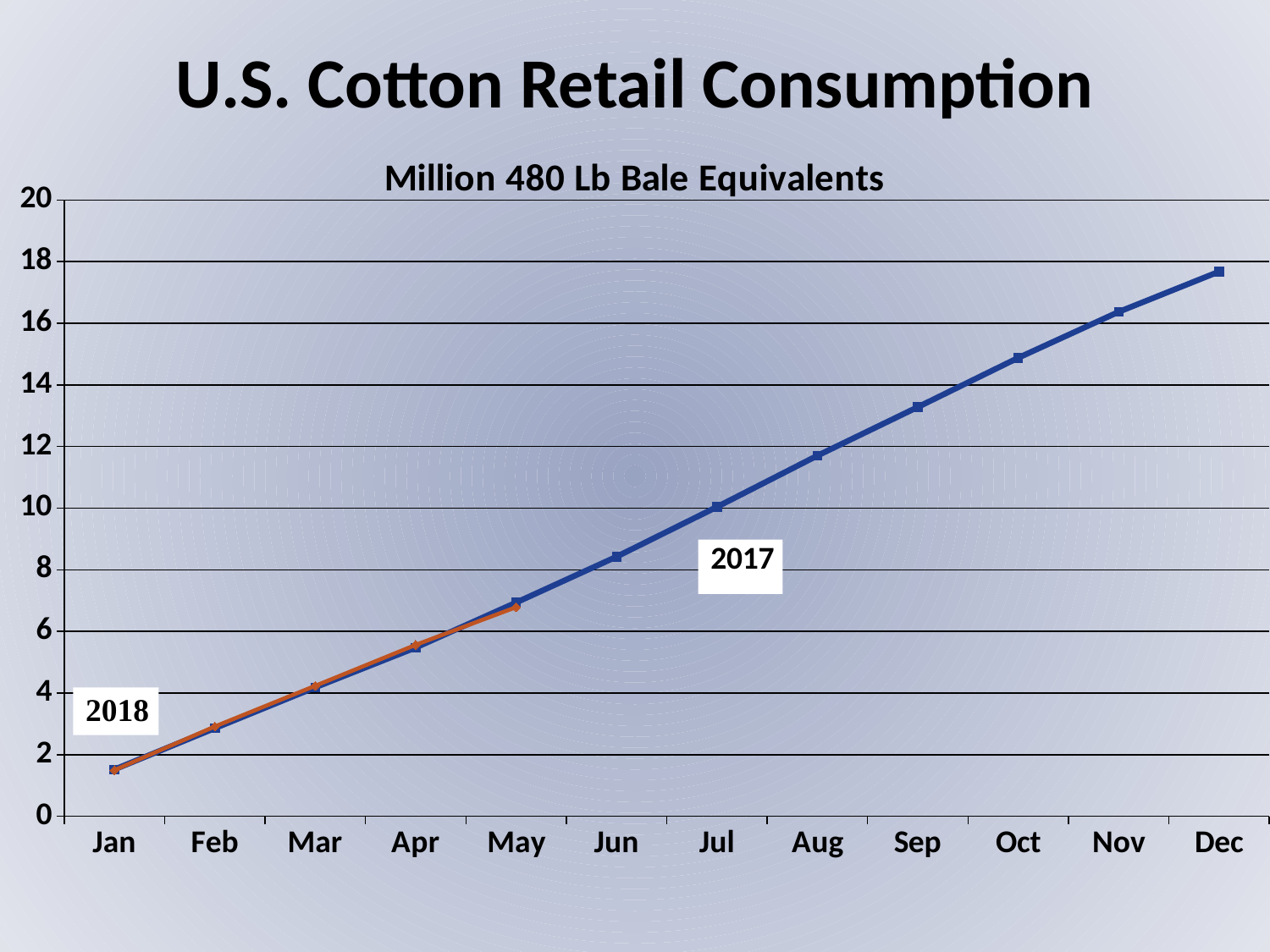
In which month is the 2017 series highest? Dec Which two years are labelled on the chart? 2017 and 2018 In which month is the 2017 series lowest? Jan Is the 2017 value for Sep greater or less than 12? greater What is the subtitle shown above the chart, giving the units? Million 480 Lb Bale Equivalents Which is larger for the 2017 series, the value for Oct or the value for Jun? Oct What kind of chart is shown on the slide? line chart How many data series are plotted on the chart? 2 Is the 2017 value for Feb greater or less than 4? less Is the 2017 value for Dec greater or less than 16? greater How many months are shown along the x axis? 12 Do the values for the 2017 series rise or fall from Jan to Dec? rise